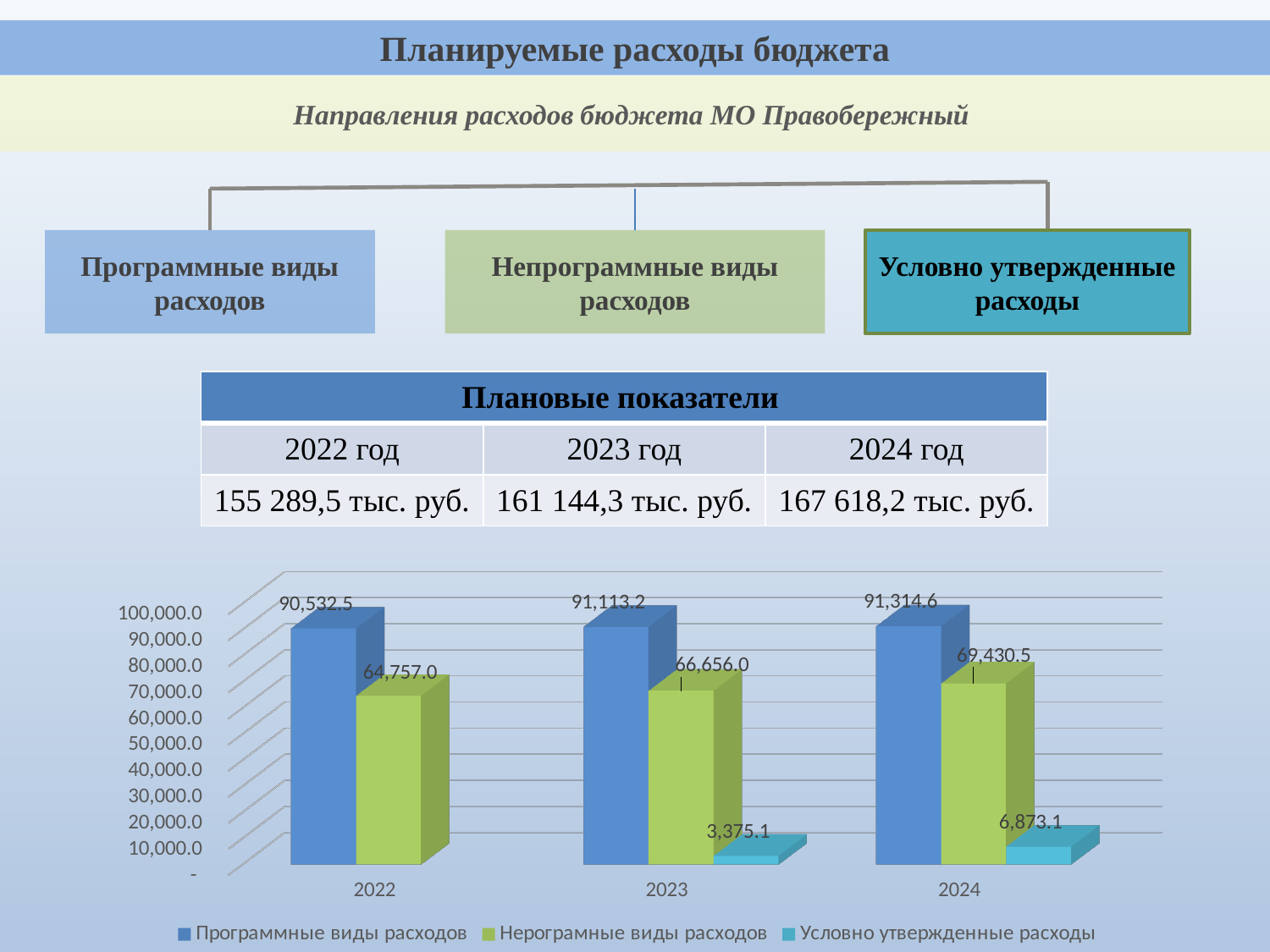
In which year is the value for Программные виды расходов the highest? 2024 In which year is the value for Нерограмные виды расходов the lowest? 2022 What is the value for Условно утвержденные расходы in 2024? 6,873.1 What is the value for Условно утвержденные расходы in 2023? 3,375.1 Which is larger in 2023: Программные виды расходов or Нерограмные виды расходов? Программные виды расходов What is the difference between Нерограмные виды расходов in 2024 and in 2022? 4,673.5 What kind of chart is shown on the slide? Bar chart What is the value for Программные виды расходов in 2022? 90,532.5 What is the difference between Условно утвержденные расходы in 2024 and in 2023? 3,498.0 How many series does the chart legend list? 3 Do the values for Нерограмные виды расходов rise or fall from 2022 to 2024? Rise What is the value for Нерограмные виды расходов in 2023? 66,656.0